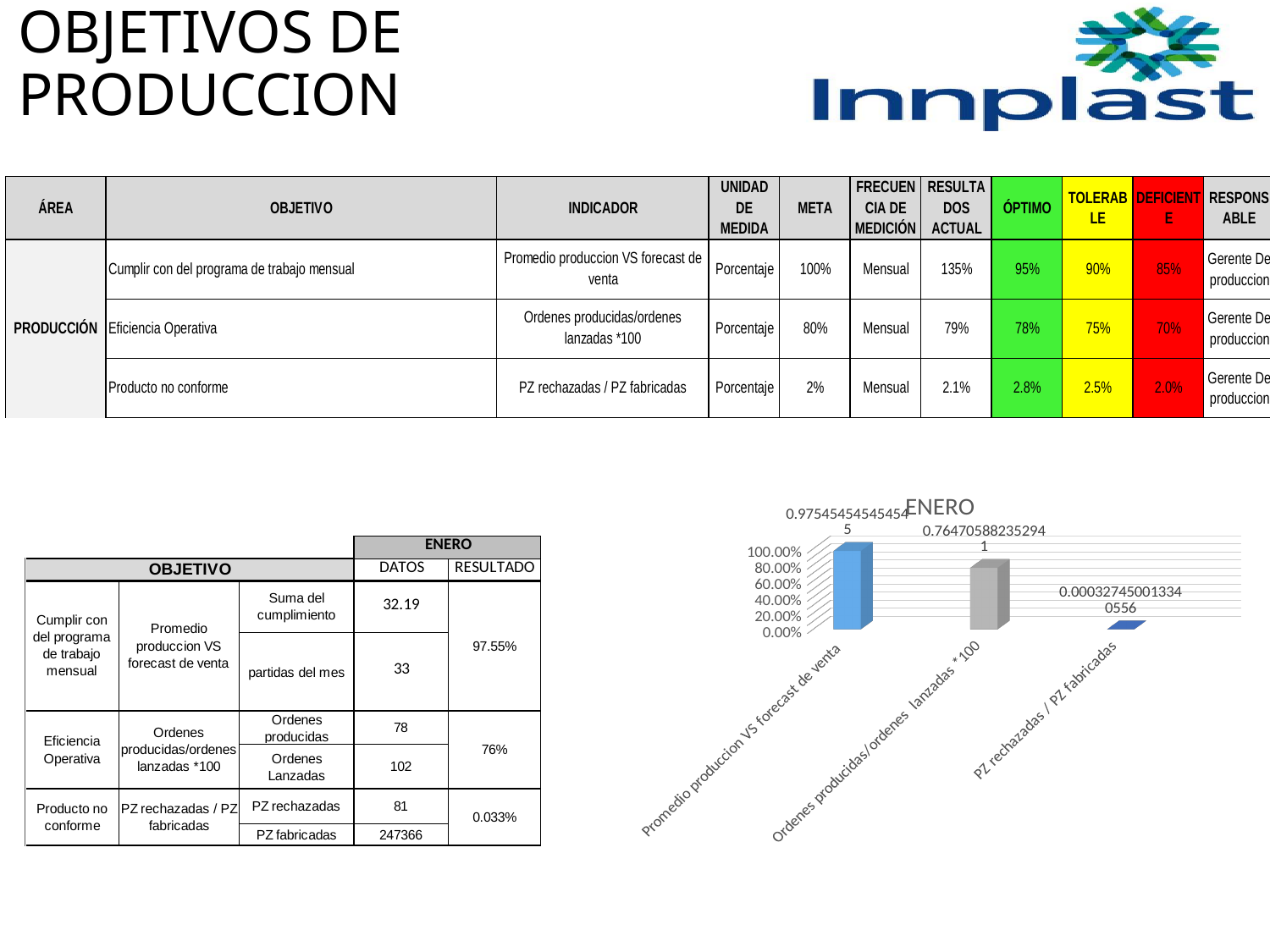
What is the data label shown for Ordenes producidas/ordenes lanzadas *100 in the ENERO chart? 0.764705882352941 How many categories are plotted in the ENERO chart? 3 In the ENERO chart, is the value for PZ rechazadas / PZ fabricadas greater or less than 20.00%? less In the ENERO chart, is the value for Ordenes producidas/ordenes lanzadas *100 greater or less than 60.00%? greater What is the data label shown for Promedio produccion VS forecast de venta in the ENERO chart? 0.975454545454545 In the ENERO chart, which is larger: the value for Promedio produccion VS forecast de venta or the value for Ordenes producidas/ordenes lanzadas *100? Promedio produccion VS forecast de venta In the ENERO chart, which category has the lowest value? PZ rechazadas / PZ fabricadas In the ENERO chart, which category has the highest value? Promedio produccion VS forecast de venta In the ENERO chart, is the value for Promedio produccion VS forecast de venta greater or less than 80.00%? greater What is the title of the chart on the slide? ENERO In the ENERO chart, do the values rise or fall from left to right across the categories? fall What kind of chart is shown on the slide? bar chart